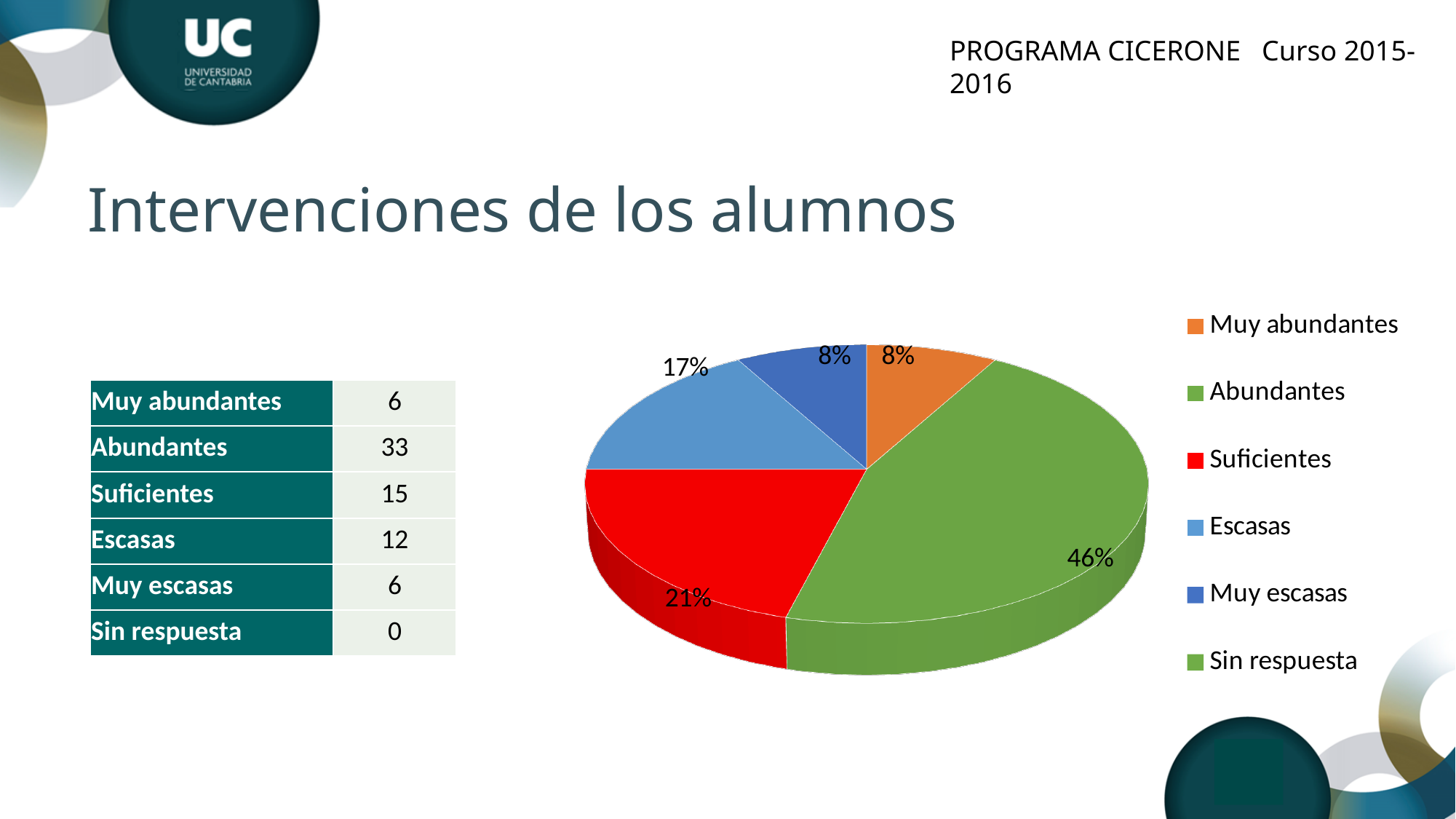
What percentage of the pie chart does the Escasas slice represent? 17% Which slice is larger in the pie chart, Abundantes or Suficientes? Abundantes What colour is the Suficientes slice in the pie chart? red How many entries does the legend of the pie chart list? 6 What is the difference in percentage points between the Abundantes slice and the Suficientes slice? 25 Which slice is larger in the pie chart, Suficientes or Escasas? Suficientes Which category has the largest slice in the pie chart? Abundantes What percentage of the pie chart does the Abundantes slice represent? 46% What type of chart is shown on the slide? pie chart What percentage of the pie chart does the Suficientes slice represent? 21%